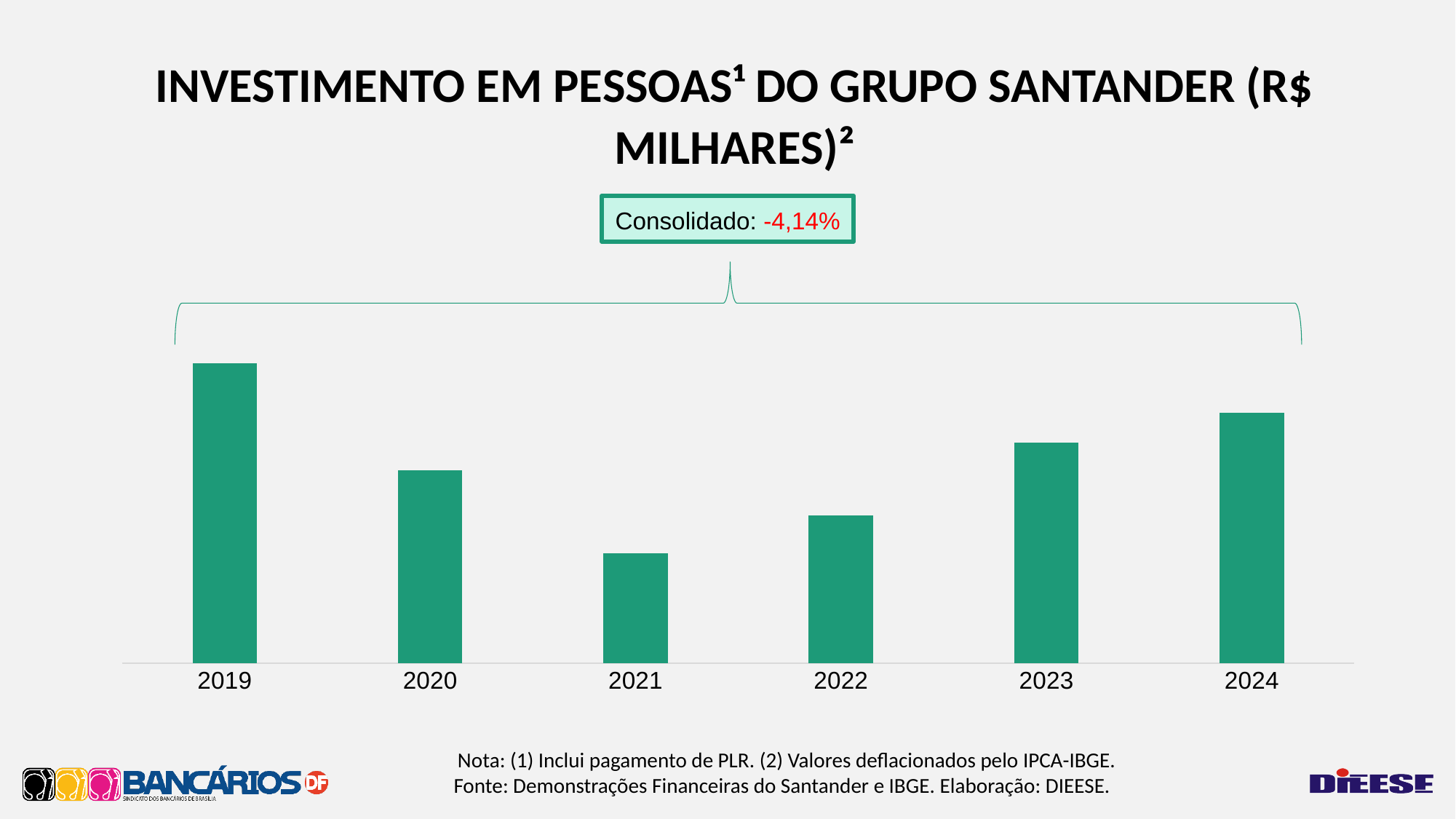
How many years are shown on the x axis of the chart? 6 Which year has the larger value, 2023 or 2024? 2024 Do the values rise or fall from 2021 to 2024? rise What is the title of the chart? INVESTIMENTO EM PESSOAS¹ DO GRUPO SANTANDER (R$ MILHARES)² Which year has the larger value, 2019 or 2024? 2019 Which year has the highest investment in people? 2019 What consolidated percentage change is shown in the box above the chart? -4,14% Which year has the larger value, 2021 or 2022? 2022 What kind of chart is shown on the slide? bar chart Which year has the lowest investment in people? 2021 Do the values rise or fall from 2019 to 2021? fall